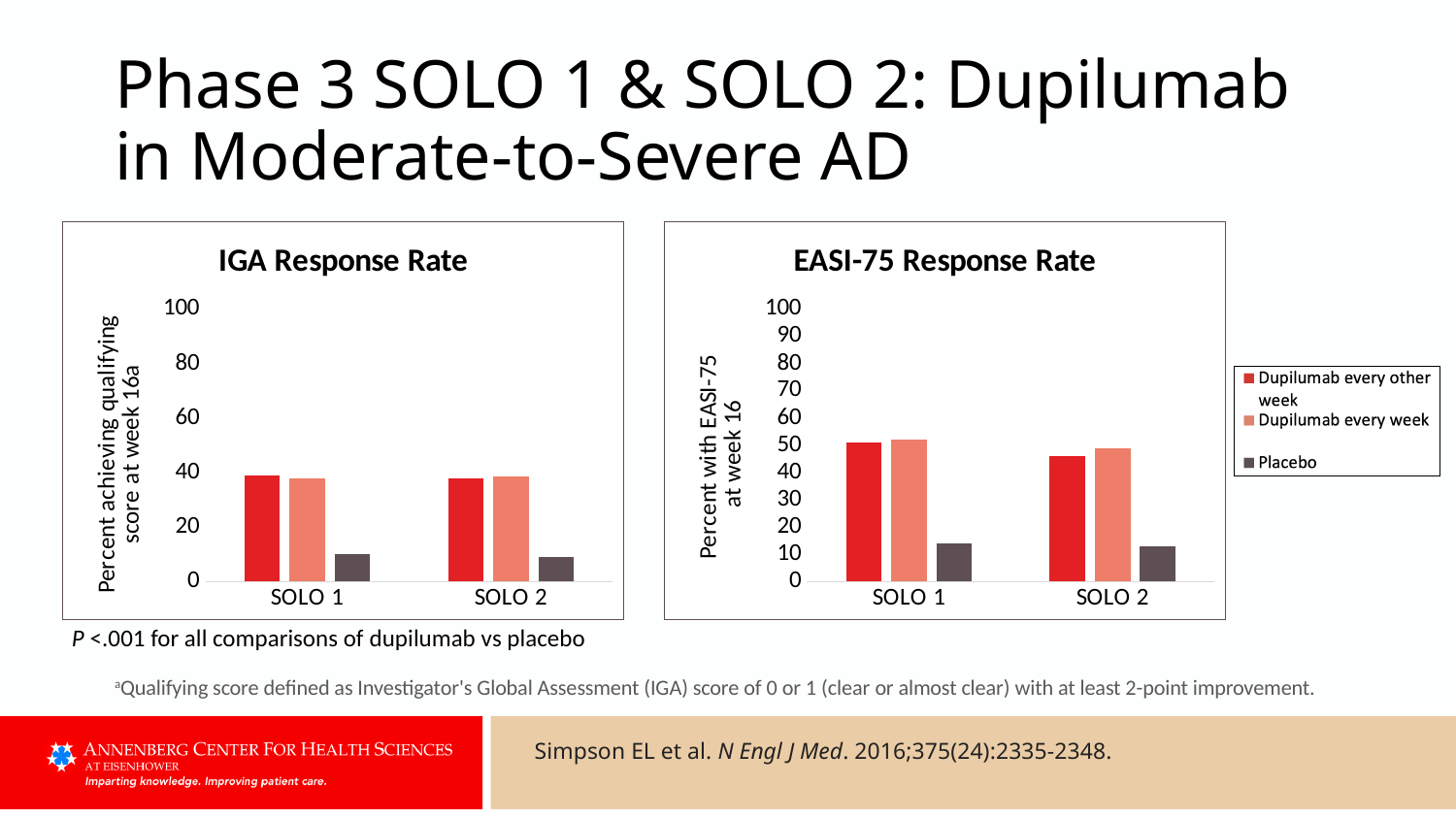
What is the y-axis label of the EASI-75 Response Rate chart? Percent with EASI-75 at week 16 In the EASI-75 Response Rate chart, is the value for Placebo in SOLO 1 greater or less than 20? less In the EASI-75 Response Rate chart, is the value for Dupilumab every week in SOLO 1 greater or less than 40? greater What kind of chart is the IGA Response Rate chart? bar chart In the EASI-75 Response Rate chart, which series has the lowest value for SOLO 2? Placebo How many series does the legend list for the charts? 3 In the EASI-75 Response Rate chart, is the value for Dupilumab every other week in SOLO 2 greater or less than 50? less How many study categories are shown on the x axis of the EASI-75 Response Rate chart? 2 What is the title of the left chart? IGA Response Rate In the EASI-75 Response Rate chart, which is larger for SOLO 1: Dupilumab every other week or Placebo? Dupilumab every other week